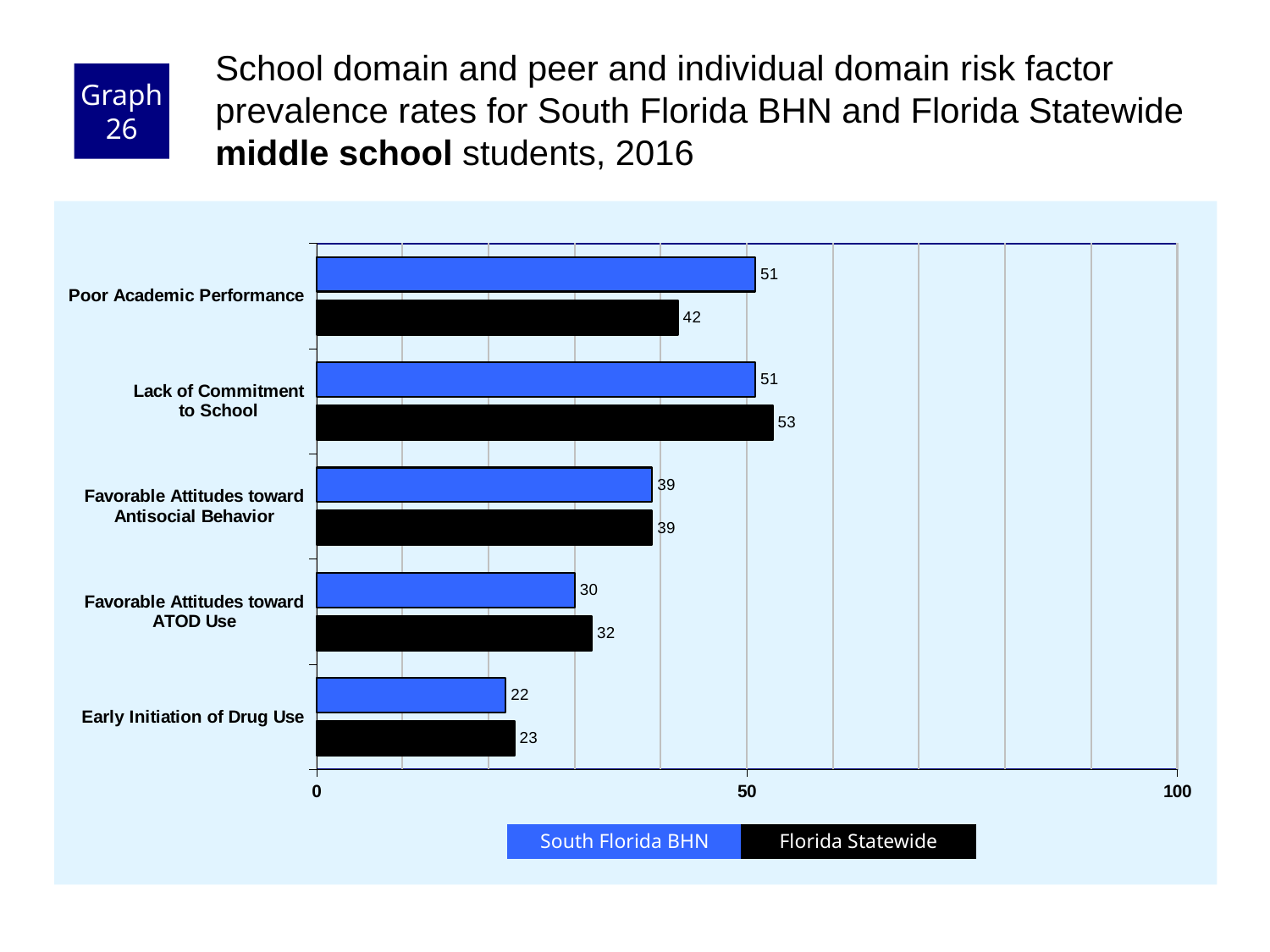
Which category has the lowest South Florida BHN value? Early Initiation of Drug Use How many risk factor categories are shown on the chart? 5 Which is larger for Favorable Attitudes toward ATOD Use: South Florida BHN or Florida Statewide? Florida Statewide What is the difference between the South Florida BHN and Florida Statewide values for Poor Academic Performance? 9 Which category has the highest Florida Statewide value? Lack of Commitment to School What is the South Florida BHN value for Favorable Attitudes toward ATOD Use? 30 Is the Florida Statewide value for Poor Academic Performance greater or less than 50? less What kind of chart is shown on the slide? bar chart What is the Florida Statewide value for Early Initiation of Drug Use? 23 What is the South Florida BHN value for Poor Academic Performance? 51 How many series does the legend list? 2 What is the Florida Statewide value for Lack of Commitment to School? 53